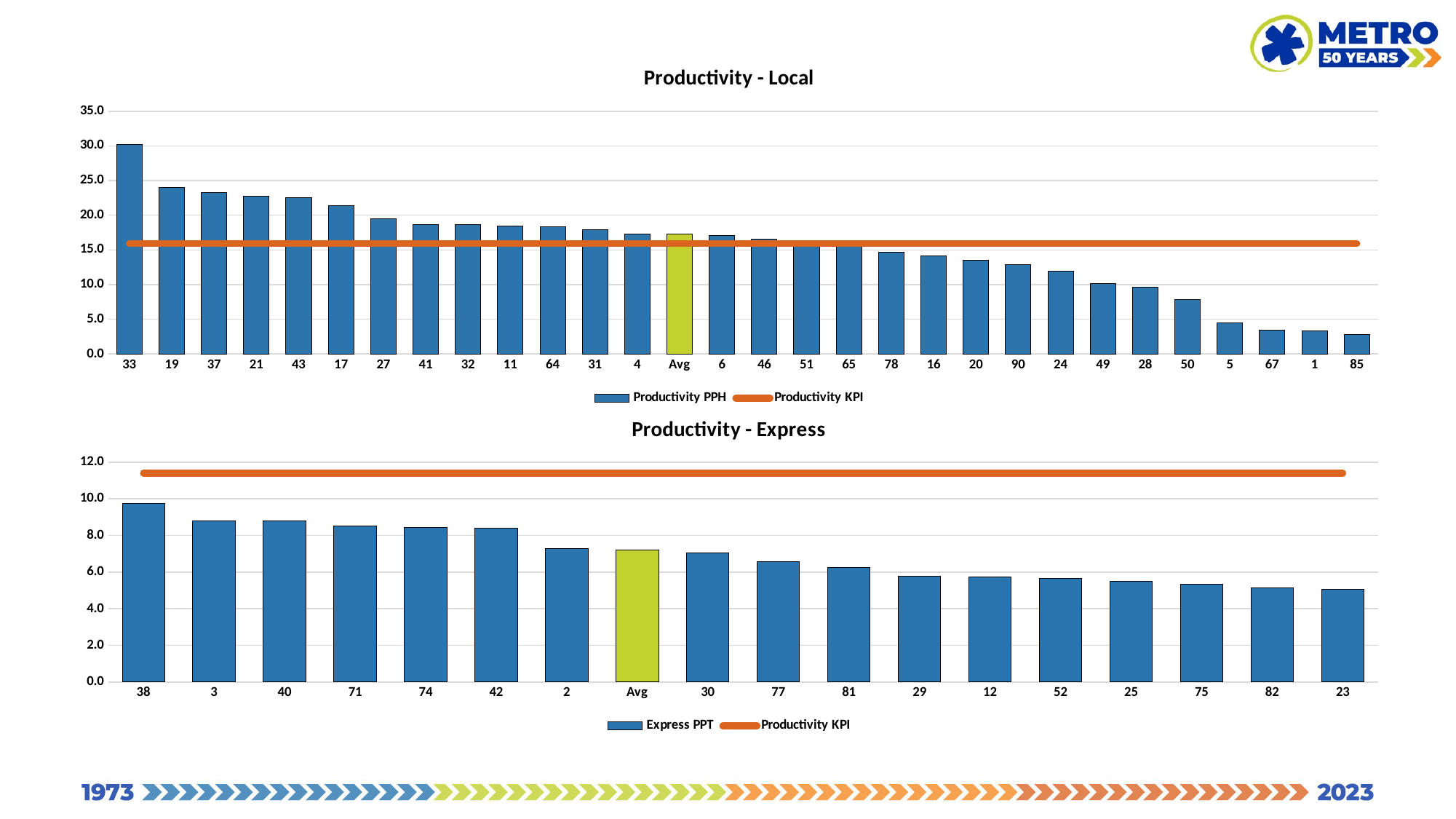
On the Productivity - Express chart, which route has the lowest Express PPT? 23 How many series does the legend of the Productivity - Local chart list? 2 On the Productivity - Local chart, which route has the lowest Productivity PPH? 85 On the Productivity - Express chart, is the value for route 2 greater or less than 6.0? greater On the Productivity - Express chart, which route has the highest Express PPT? 38 How many bars are plotted on the Productivity - Local chart? 30 How many bars are plotted on the Productivity - Express chart? 18 On the Productivity - Local chart, is the value for route 33 greater or less than 25.0? greater On the Productivity - Local chart, which has the higher Productivity PPH, route 19 or route 17? 19 On the Productivity - Local chart, which route has the highest Productivity PPH? 33 On the Productivity - Local chart, is the value for route 50 greater or less than 10.0? less On the Productivity - Express chart, do the bar values rise or fall from left to right? fall